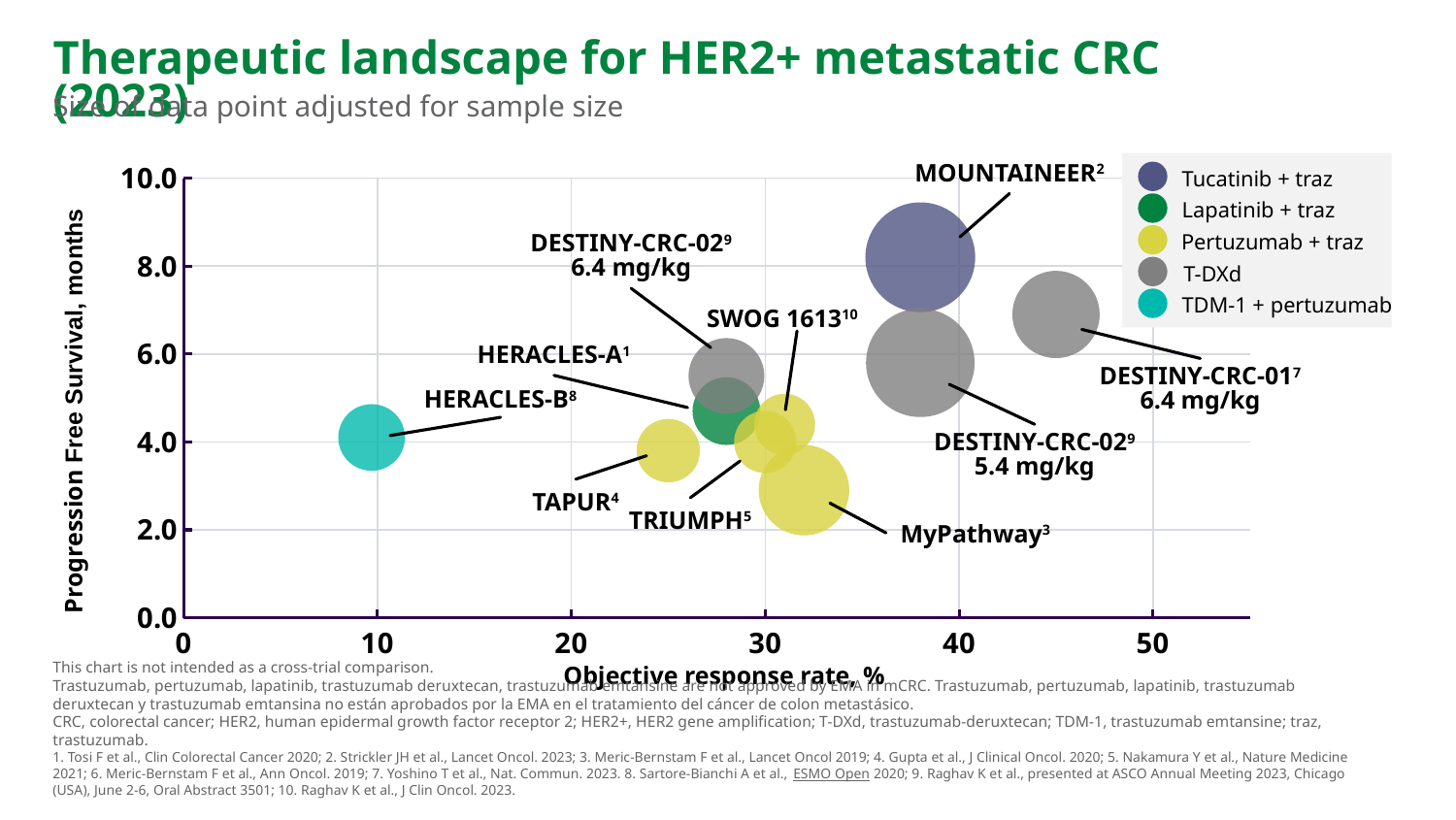
How many labelled trial data points are plotted on the chart? 10 What is the label of the x axis? Objective response rate, % Is the progression free survival for MOUNTAINEER greater or less than 6.0 months? greater How many entries does the legend list? 5 What kind of chart is shown on the slide? Bubble chart Which trial has the highest objective response rate on the chart? DESTINY-CRC-01 6.4 mg/kg Which trial has the lowest objective response rate on the chart? HERACLES-B Which has the higher progression free survival, MOUNTAINEER or HERACLES-B? MOUNTAINEER Which treatment does the grey colour represent in the legend? T-DXd Is the objective response rate for DESTINY-CRC-01 6.4 mg/kg greater or less than 40? greater Is the objective response rate for HERACLES-B greater or less than 20? less Which trial has the highest progression free survival on the chart? MOUNTAINEER